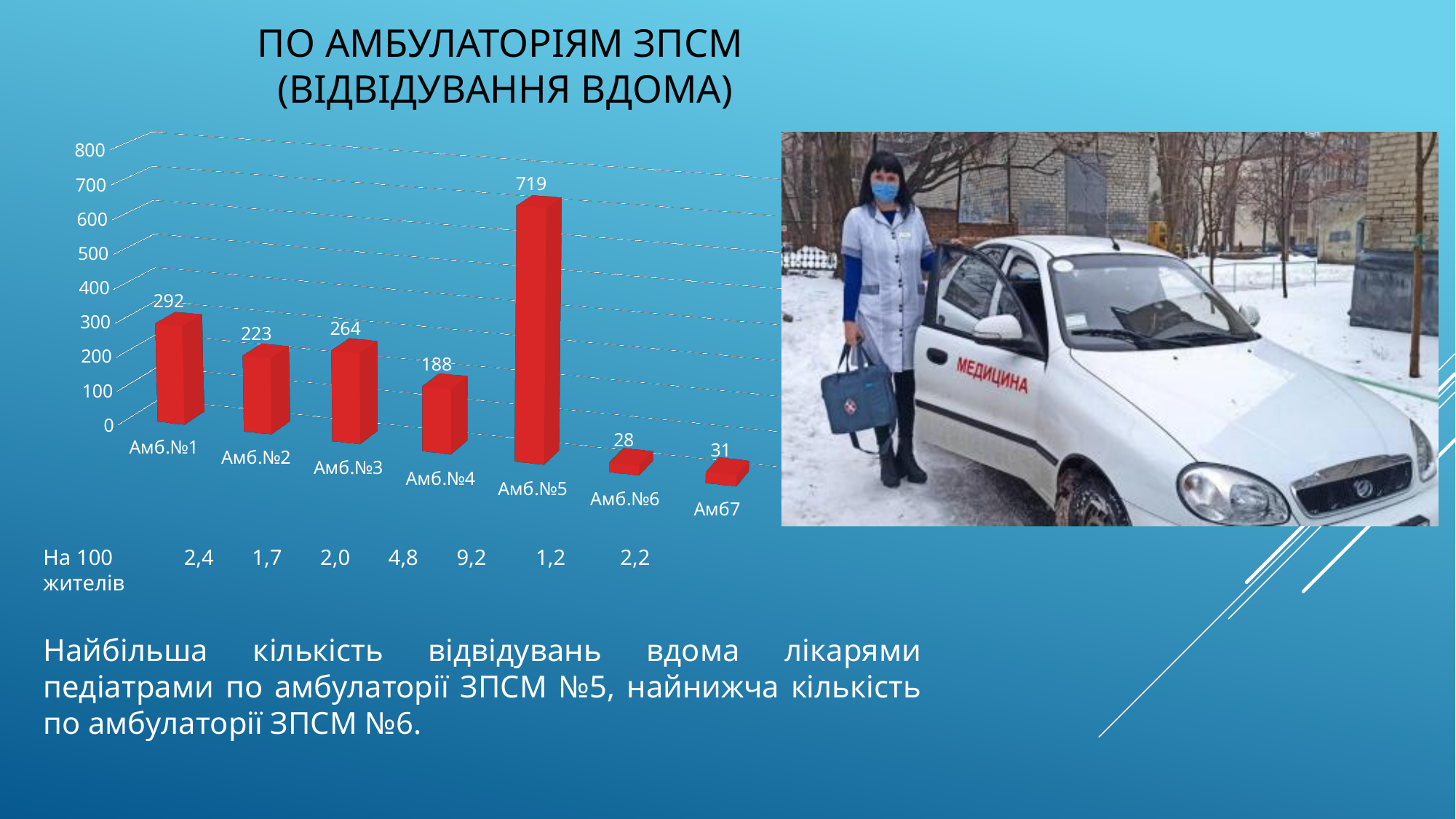
Which category has the lowest value? Амб.№6 Which is larger, the value for Амб.№2 or the value for Амб.№3? Амб.№3 What is the value for Амб.№5? 719 Is the value for Амб.№5 greater or less than 600? greater What colour are the bars in the chart? red Which category has the highest value? Амб.№5 What is the difference between the values for Амб.№5 and Амб.№1? 427 What is the difference between the values for Амб.№3 and Амб.№2? 41 What kind of chart is shown on the slide? bar chart What is the value for Амб.№4? 188 What is the value for Амб.№1? 292 How many categories are shown on the chart? 7